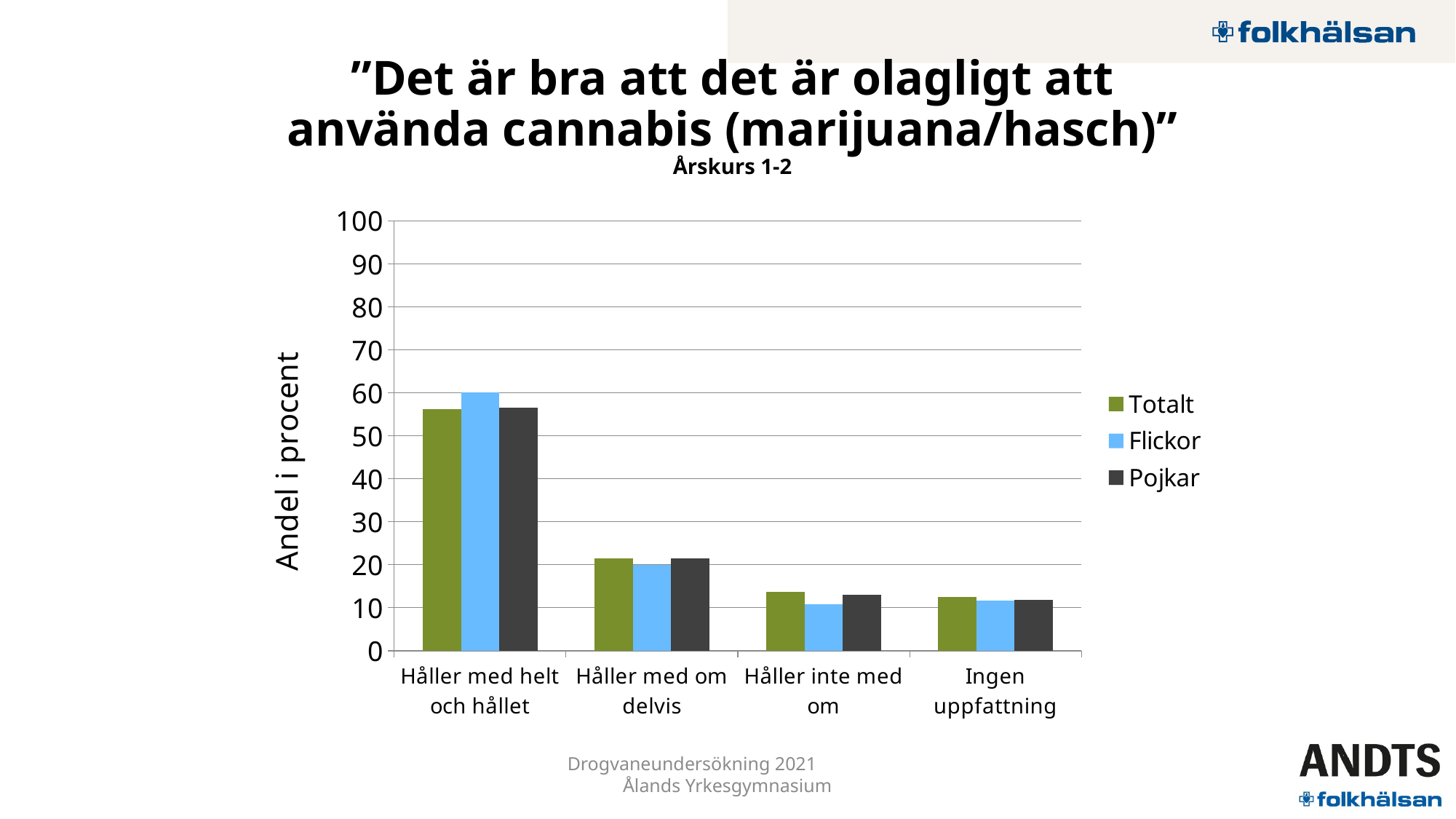
For 'Håller inte med om', which is larger: Totalt or Flickor? Totalt Is the value for Flickor in 'Håller med om delvis' greater or less than 30? less What is the title of the y axis? Andel i procent For 'Håller med helt och hållet', which is larger: Flickor or Pojkar? Flickor Do the values for Totalt rise or fall from left to right along the x axis? fall How many categories are shown on the x axis? 4 Is the value for Pojkar in 'Håller med helt och hållet' greater or less than 60? less Is the value for Totalt in 'Håller med helt och hållet' greater or less than 50? greater Which category has the highest value for Totalt? Håller med helt och hållet How many series does the legend list? 3 What kind of chart is shown on the slide? bar chart Which series is shown in green in the legend? Totalt